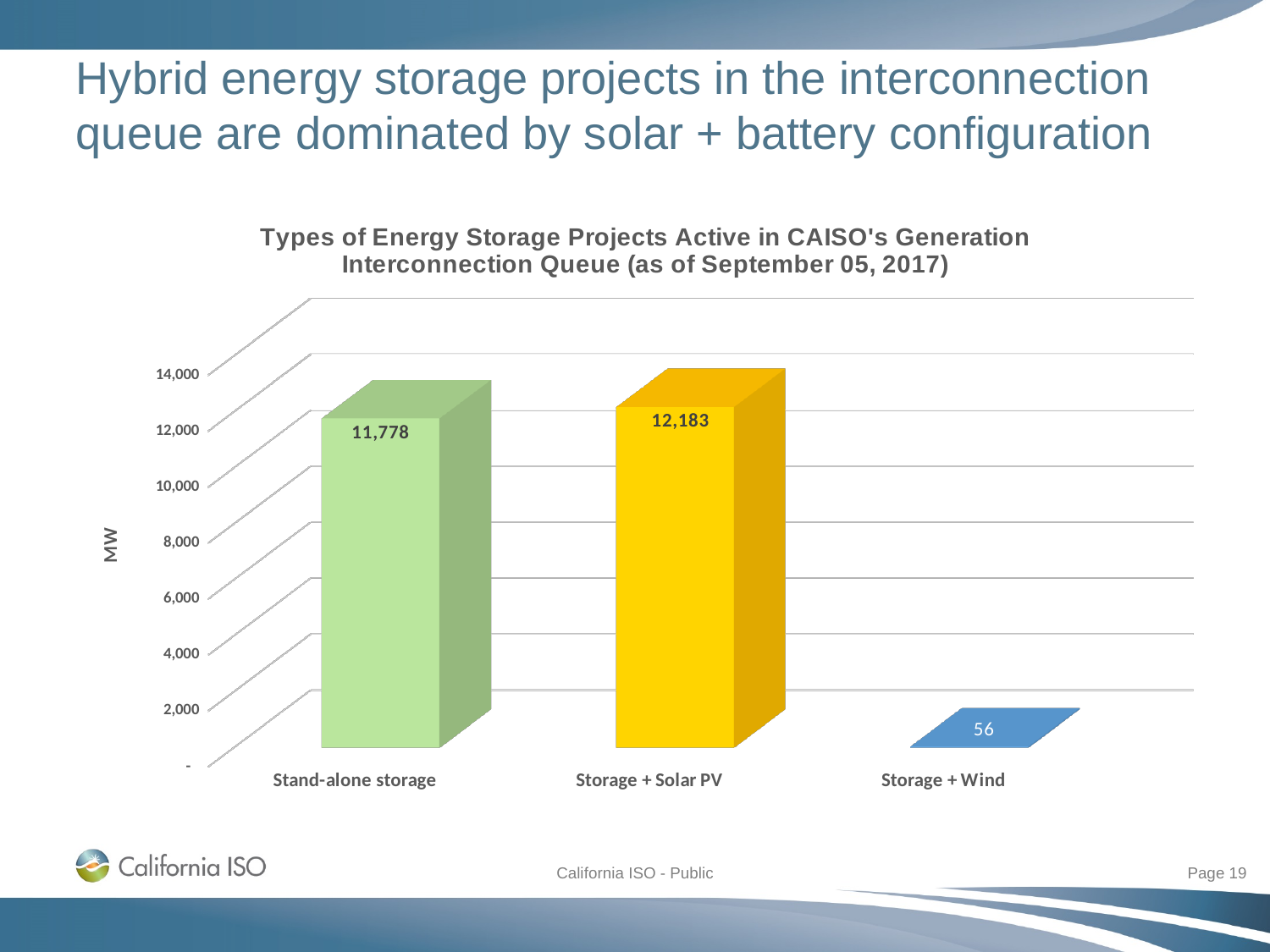
What is the value for Stand-alone storage? 11,778 Which is larger, the value for Stand-alone storage or the value for Storage + Wind? Stand-alone storage What is the difference between the values for Stand-alone storage and Storage + Wind? 11,722 What is the value for Storage + Wind? 56 What is the label of the vertical axis? MW What is the difference between the values for Storage + Solar PV and Stand-alone storage? 405 What kind of chart is shown on the slide? Bar chart Which category has the highest value? Storage + Solar PV How many categories are shown in the chart? 3 What is the value for Storage + Solar PV? 12,183 What is the title of the chart? Types of Energy Storage Projects Active in CAISO's Generation Interconnection Queue (as of September 05, 2017) Which category has the lowest value? Storage + Wind